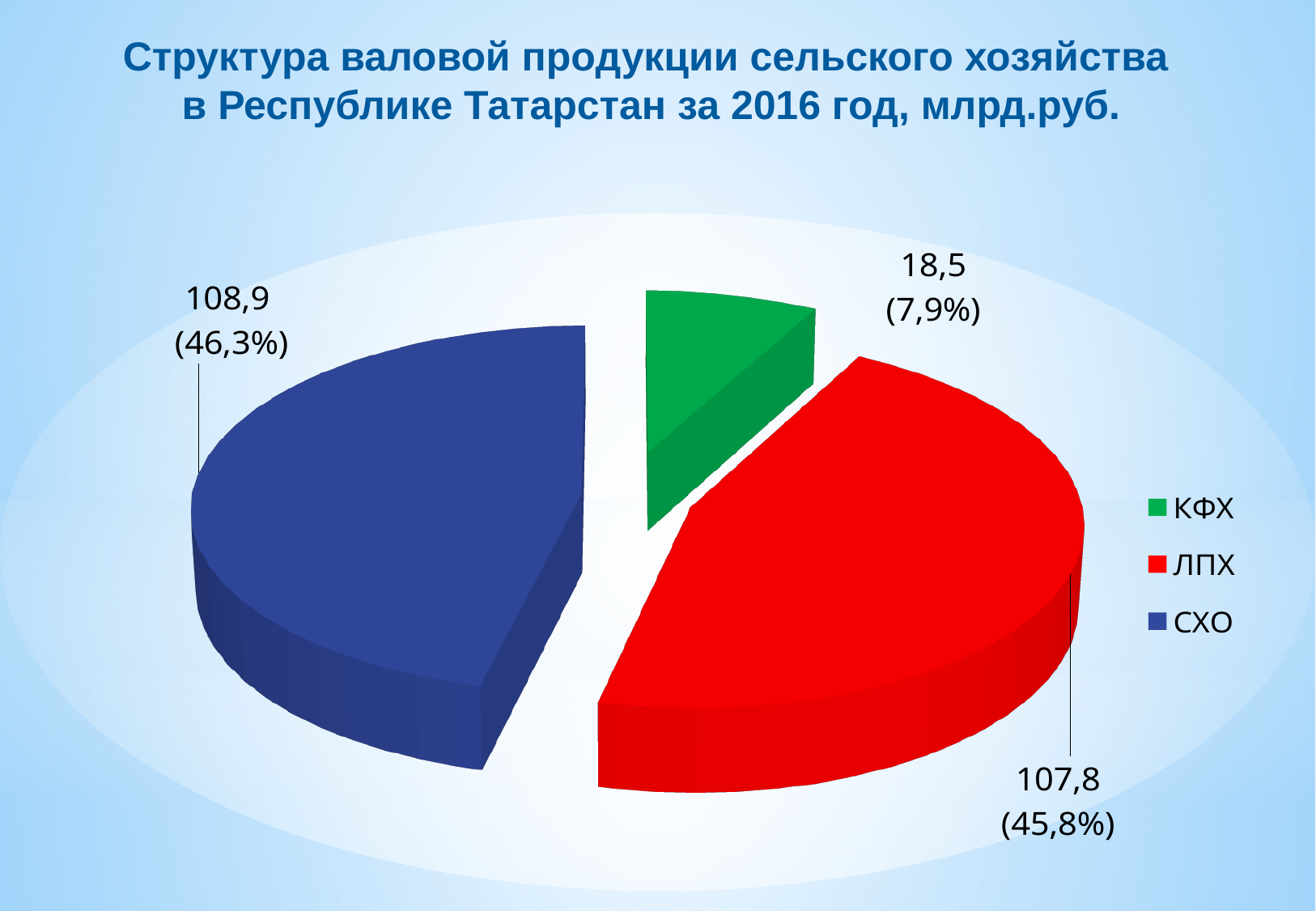
Which category has the largest value? СХО How many slices does the pie chart have? 3 What kind of chart is shown on the slide? Pie chart Which colour represents ЛПХ in the chart? Red What is the value for СХО? 108,9 What is the value for ЛПХ? 107,8 What is the value for КФХ? 18,5 What share of the pie does КФХ represent? 7,9% What is the difference between the values for СХО and КФХ? 90,4 Which category has the smallest value? КФХ What share of the pie does ЛПХ represent? 45,8% What share of the pie does СХО represent? 46,3%